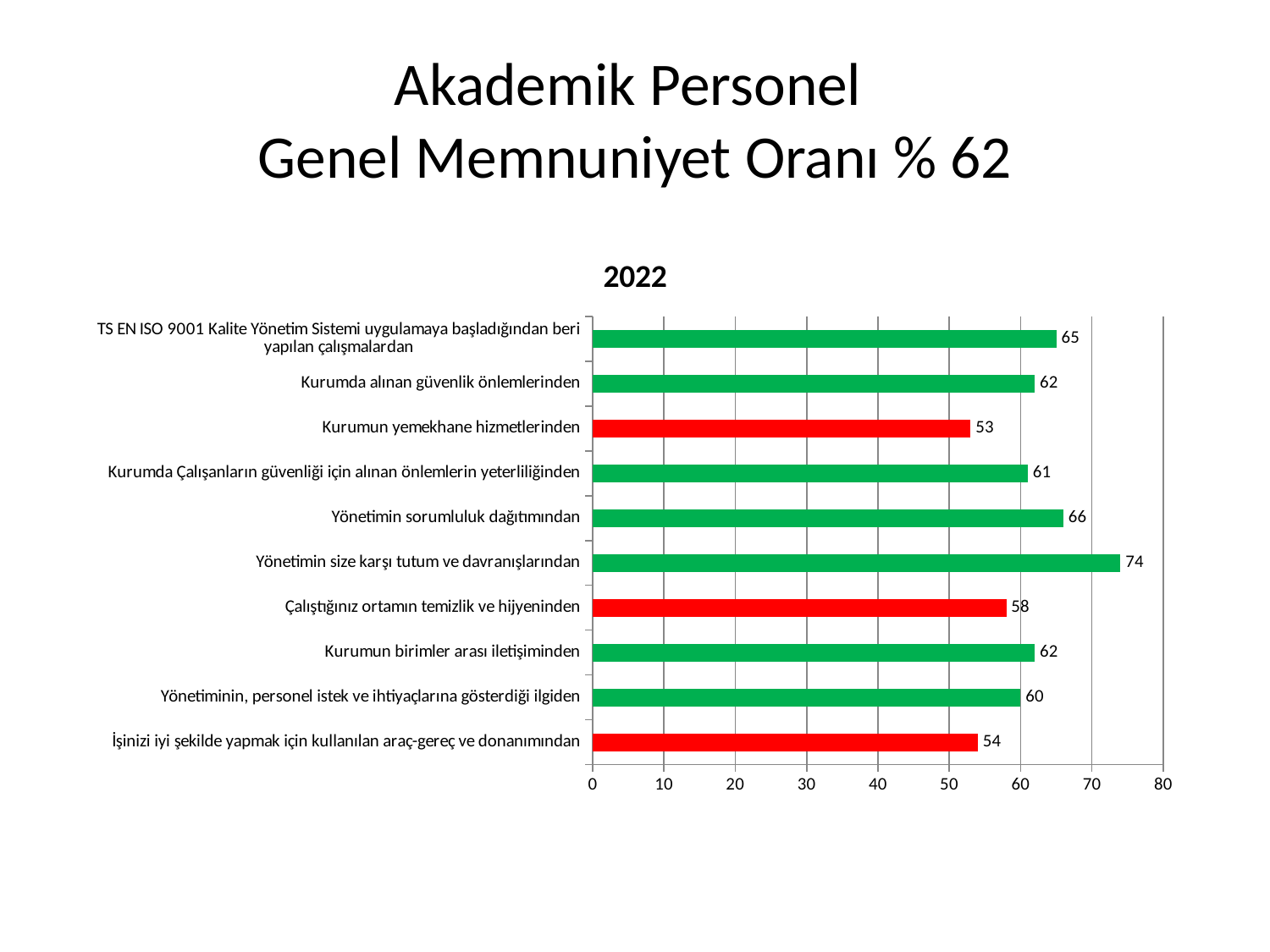
What kind of chart is shown on the slide? bar chart Which is larger: the value for "Yönetimin sorumluluk dağıtımından" or the value for "Kurumda alınan güvenlik önlemlerinden"? Yönetimin sorumluluk dağıtımından Which category has the lowest value? Kurumun yemekhane hizmetlerinden What is the value for "Yönetimin size karşı tutum ve davranışlarından"? 74 What is the difference between the values for "Yönetimin size karşı tutum ve davranışlarından" and "Kurumun yemekhane hizmetlerinden"? 21 How many categories are shown in the chart? 10 What is the title of the chart? 2022 How many bars are coloured red? 3 What is the value for "Çalıştığınız ortamın temizlik ve hijyeninden"? 58 Is the value for "İşinizi iyi şekilde yapmak için kullanılan araç-gereç ve donanımından" greater or less than 60? less Which category has the highest value? Yönetimin size karşı tutum ve davranışlarından What is the value for "Kurumun yemekhane hizmetlerinden"? 53